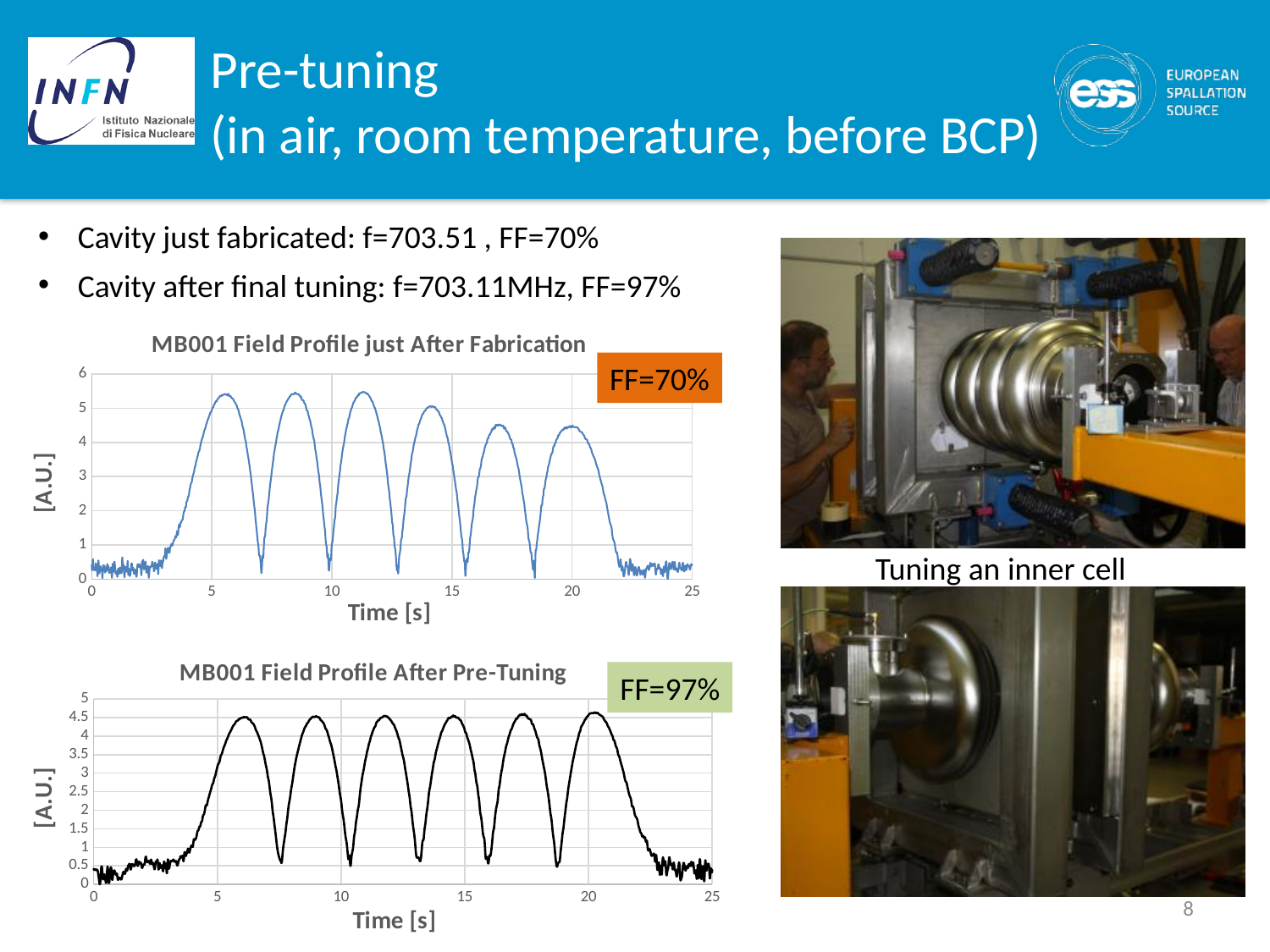
In the chart 'MB001 Field Profile just After Fabrication', how many peaks does the field profile show? 6 What kind of chart is 'MB001 Field Profile just After Fabrication'? line chart In the chart 'MB001 Field Profile just After Fabrication', is the height of the last peak greater or less than 5? less In the chart 'MB001 Field Profile just After Fabrication', do the peak heights rise or fall as time increases? fall In the chart 'MB001 Field Profile just After Fabrication', is the height of the first peak greater or less than 5? greater In the chart 'MB001 Field Profile just After Fabrication', which is higher, the first peak or the last peak? the first peak What kind of chart is 'MB001 Field Profile After Pre-Tuning'? line chart In the chart 'MB001 Field Profile After Pre-Tuning', is the height of the first peak greater or less than 4? greater What FF value is annotated on the chart 'MB001 Field Profile After Pre-Tuning'? FF=97% In the chart 'MB001 Field Profile After Pre-Tuning', how many peaks does the field profile show? 6 What is the x-axis label of the chart 'MB001 Field Profile After Pre-Tuning'? Time [s]